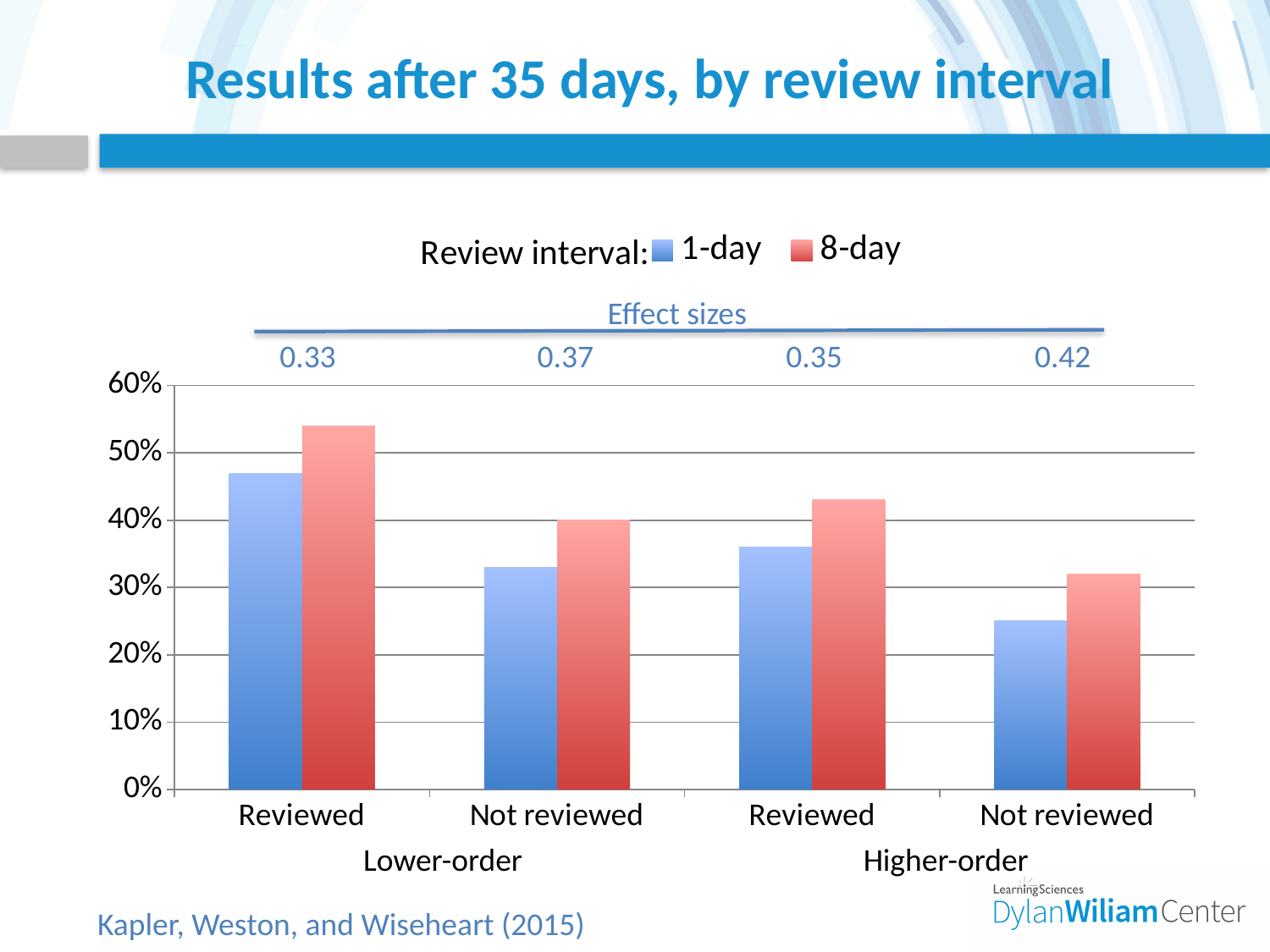
Which bar is the highest in the chart? 8-day, Reviewed (Lower-order) Is the 8-day value for Reviewed (Higher-order) greater or less than 40%? greater Which bar is the lowest in the chart? 1-day, Not reviewed (Higher-order) What kind of chart is shown on the slide? bar chart For Not reviewed (Lower-order), which is larger, the 1-day or the 8-day value? 8-day What effect size is printed above the Not reviewed (Higher-order) category? 0.42 What are the two series named in the legend? 1-day and 8-day Is the 8-day value for Reviewed (Lower-order) greater or less than 50%? greater How many series does the legend list? 2 Is the 1-day value for Not reviewed (Higher-order) greater or less than 30%? less How many categories are shown along the x axis? 4 What effect size is printed above the Reviewed (Lower-order) category? 0.33